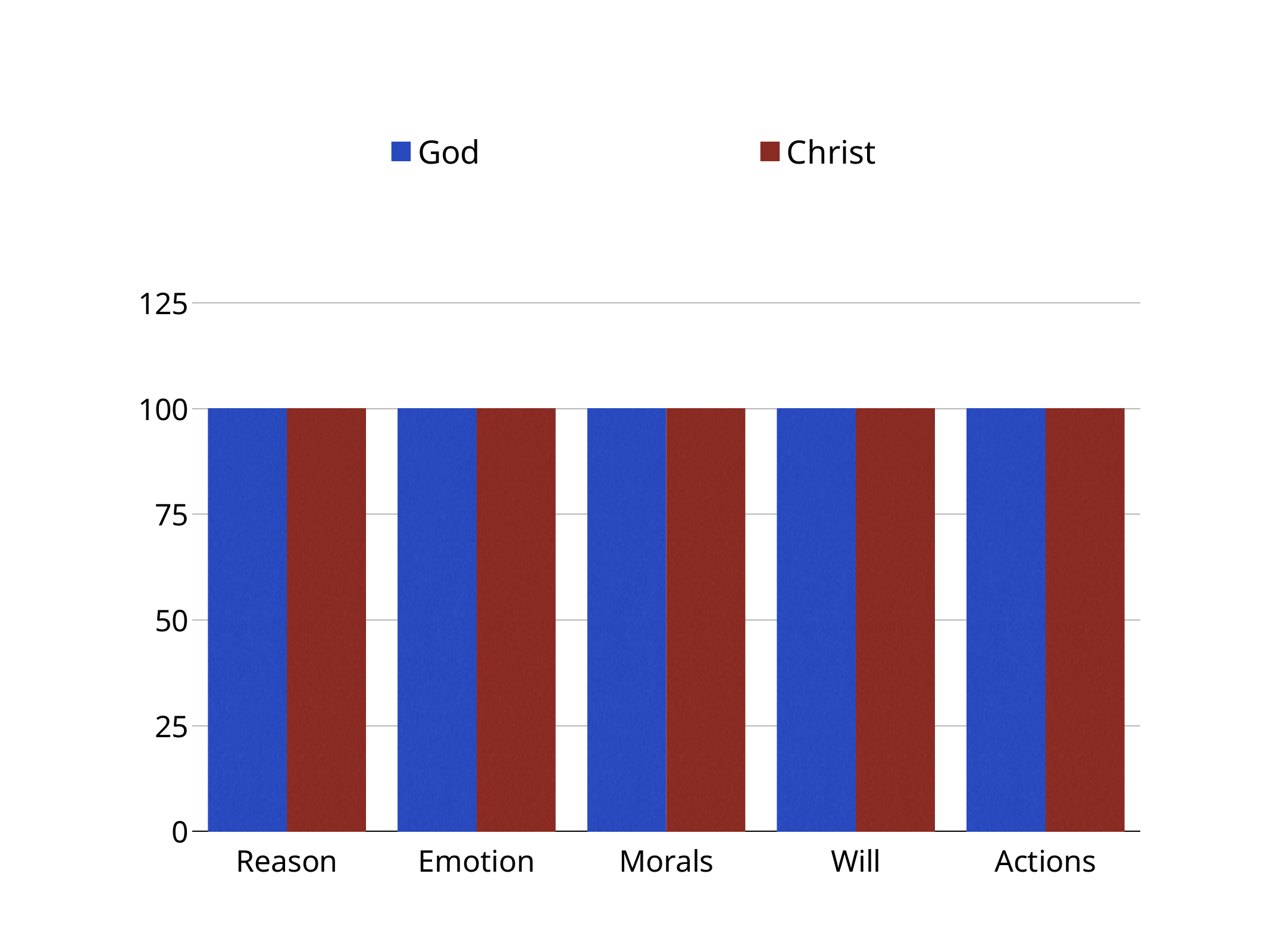
Which series is shown in blue in the legend? God How many categories are shown on the x axis? 5 Is the value for God in the Morals category greater or less than 75? greater What is the value for Christ in the Emotion category? 100 Is the value for Christ in the Will category greater or less than 125? less What is the value for God in the Will category? 100 Which series is shown in dark red in the legend? Christ What is the value for God in the Reason category? 100 What is the value for Christ in the Actions category? 100 How many series does the legend list? 2 What is the difference between the God and Christ values in the Actions category? 0 What kind of chart is shown on the slide? bar chart